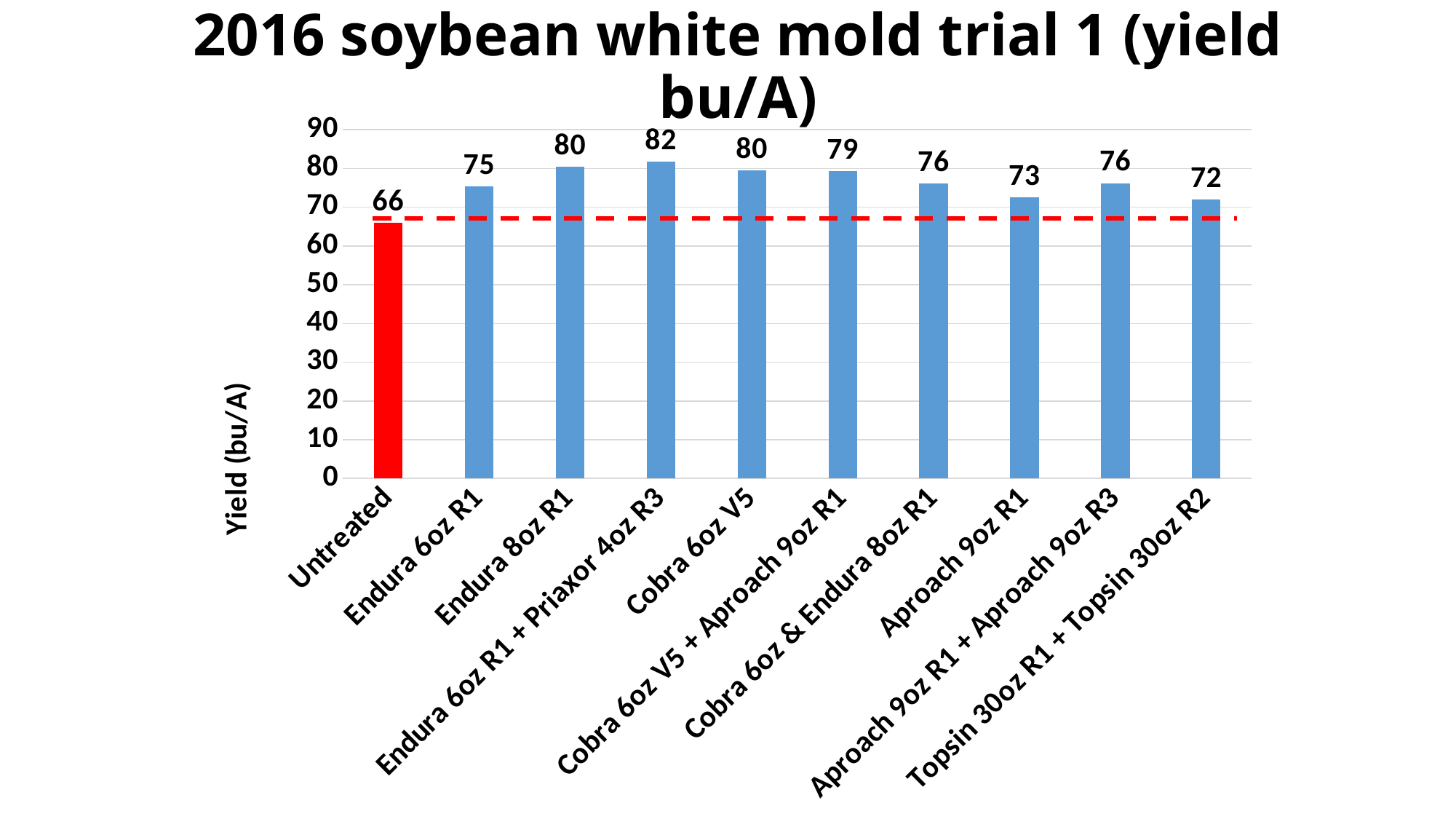
What kind of chart is this? Bar chart What is the yield for Endura 6oz R1 + Priaxor 4oz R3? 82 What is the yield for Cobra 6oz V5 + Aproach 9oz R1? 79 Which has a higher yield, Endura 8oz R1 or Aproach 9oz R1? Endura 8oz R1 What is the title of the chart? 2016 soybean white mold trial 1 (yield bu/A) Which treatment has the highest yield? Endura 6oz R1 + Priaxor 4oz R3 What is the yield for Untreated? 66 Which bar is coloured red? Untreated What is the difference in yield between Endura 6oz R1 + Priaxor 4oz R3 and Untreated? 16 Which treatment has the lowest yield? Untreated What is the yield for Topsin 30oz R1 + Topsin 30oz R2? 72 How many treatments are shown on the chart? 10